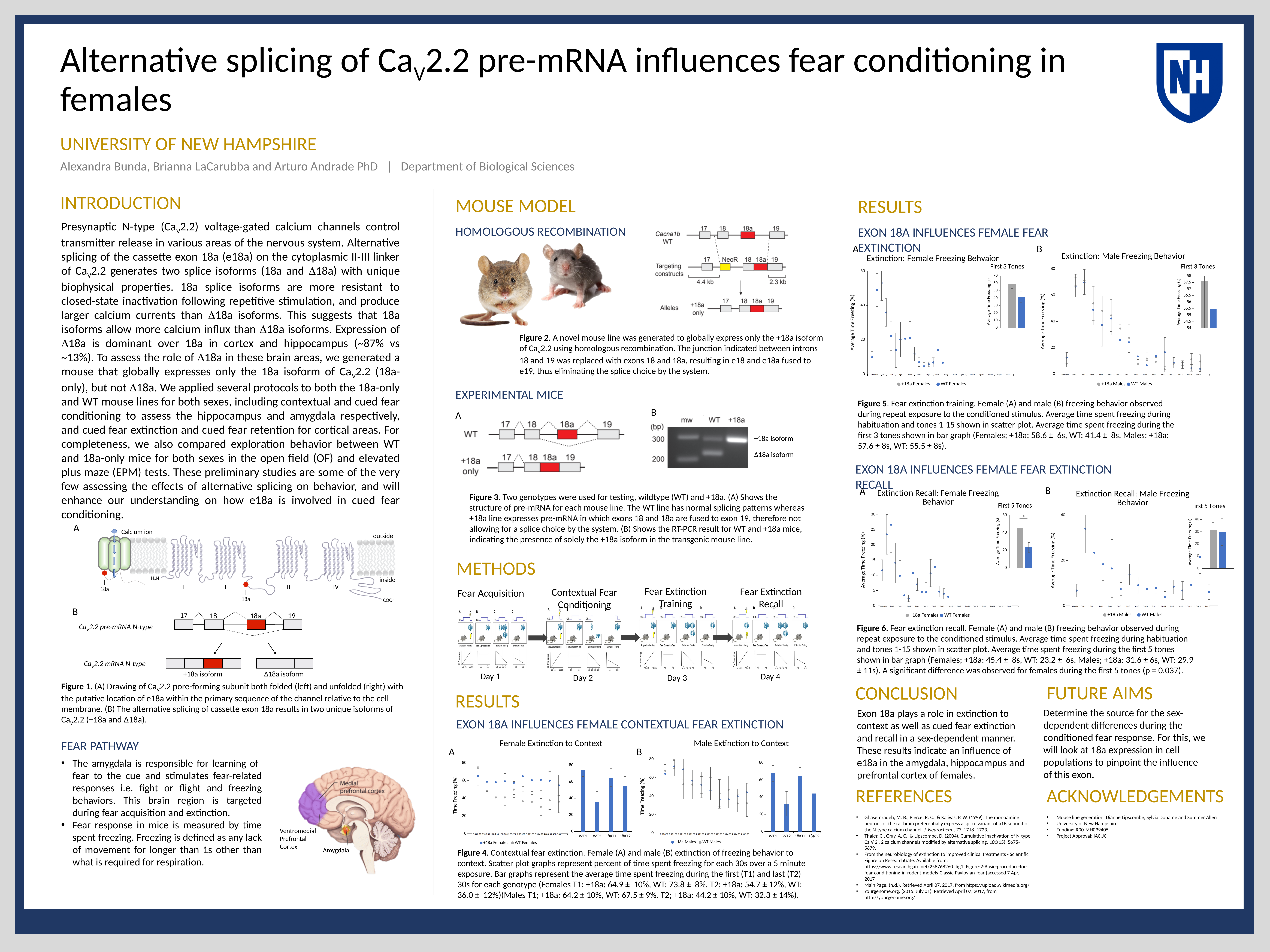
In the 'First 3 Tones' inset of the 'Extinction: Female Freezing Behvaior' chart, is the gray (+18a) bar greater or less than 50? greater In the 'Female Extinction to Context' chart, which bar is the shortest? WT2 In the 'Male Extinction to Context' chart, which bar is the shortest? WT2 In the 'Female Extinction to Context' chart, which bar is the tallest? WT1 In the 'Female Extinction to Context' bar graph, is the value for WT2 greater or less than 40? less What are the two legend entries of the 'Extinction: Male Freezing Behavior' chart? +18a Males and WT Males In the 'First 5 Tones' inset of the 'Extinction Recall: Female Freezing Behavior' chart, which bar is taller, the gray (+18a) bar or the blue (WT) bar? gray (+18a) In the 'Female Extinction to Context' bar graph, is the value for WT1 greater or less than 60? greater In the 'Extinction: Female Freezing Behvaior' chart, what kind of chart is the 'First 3 Tones' inset? bar chart In the 'Female Extinction to Context' chart, how many bars are in the bar graph? 4 How many series does the legend of the 'Female Extinction to Context' chart list? 2 In the 'Male Extinction to Context' bar graph, which is larger, WT1 or WT2? WT1